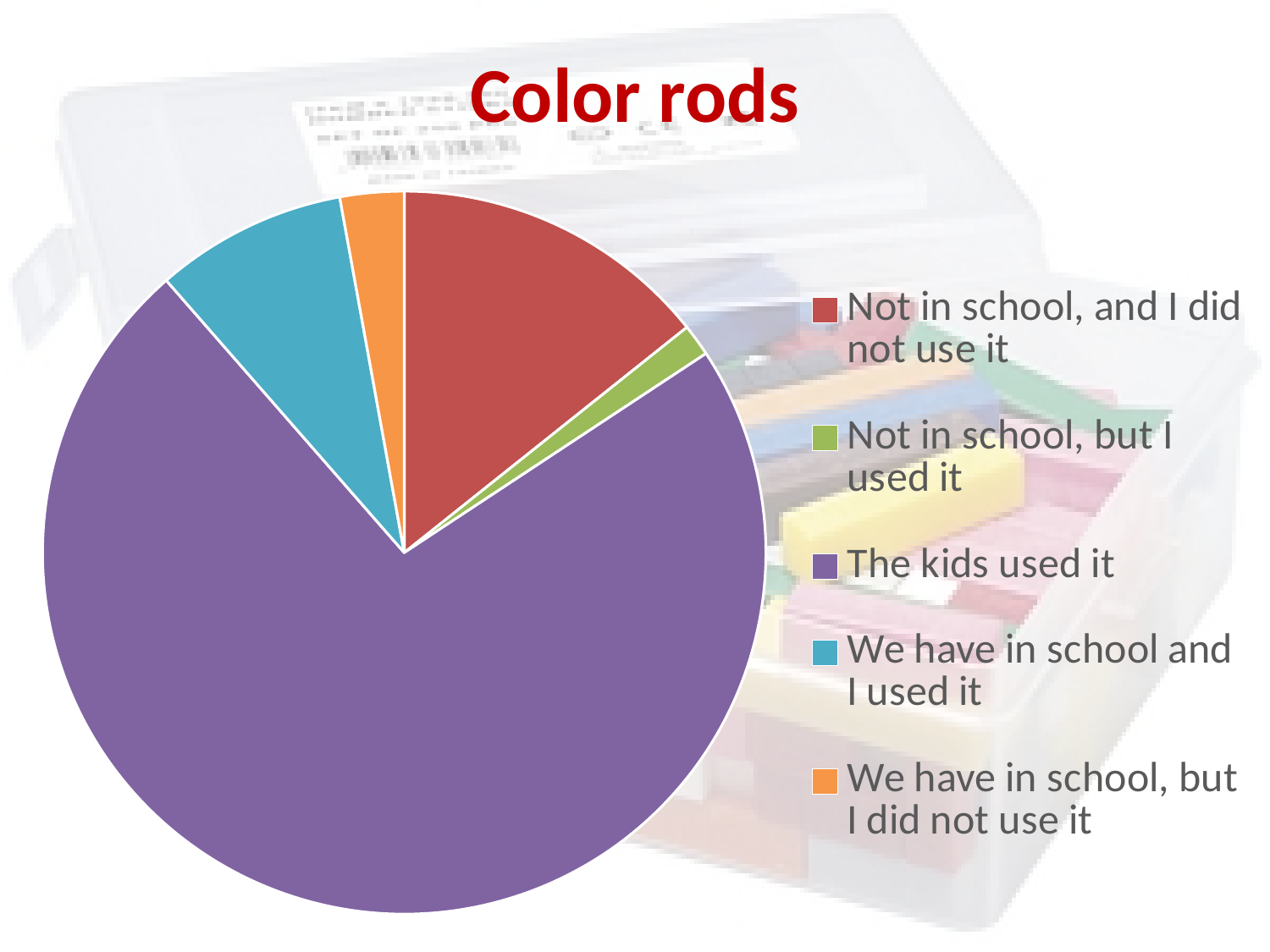
What is the title of the slide containing the pie chart? Color rods Which slice is larger: "We have in school and I used it" or "We have in school, but I did not use it"? We have in school and I used it What colour is the slice for "The kids used it"? Purple Which slice is larger: "Not in school, and I did not use it" or "We have in school and I used it"? Not in school, and I did not use it How many categories does the pie chart have? 5 Which slice is larger: "The kids used it" or "Not in school, and I did not use it"? The kids used it Which category has the largest slice of the pie chart? The kids used it What kind of chart is shown on the slide? Pie chart Which category has the smallest slice of the pie chart? Not in school, but I used it